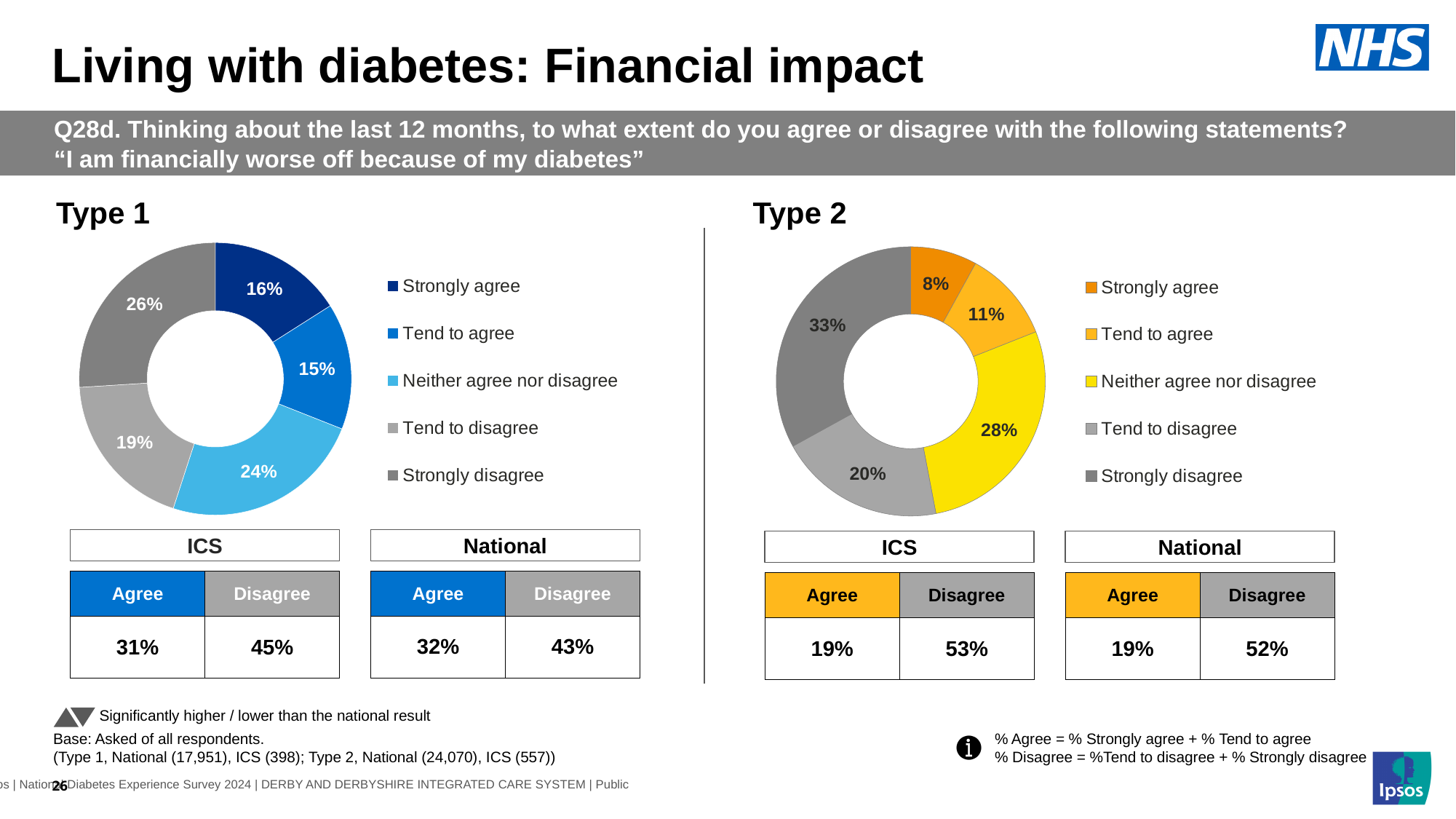
In the Type 1 chart, what percentage of respondents strongly agree? 16% In the Type 2 chart, what percentage of respondents neither agree nor disagree? 28% In the Type 2 chart, what is the difference between the Strongly disagree and Strongly agree shares? 25 percentage points In the Type 2 chart, what colour is the Neither agree nor disagree segment? Yellow In the Type 1 chart, what is the combined share of Strongly agree and Tend to agree? 31% In the Type 1 chart, what percentage of respondents tend to disagree? 19% In the Type 2 chart, which response category has the highest share? Strongly disagree How many response categories does the Type 2 chart's legend list? 5 In the Type 2 chart, what percentage of respondents strongly agree? 8% What kind of chart is used for Type 1? Doughnut (pie) chart In the Type 1 chart, which response category has the lowest share? Tend to agree In the Type 1 chart, which is larger: Neither agree nor disagree or Tend to disagree? Neither agree nor disagree